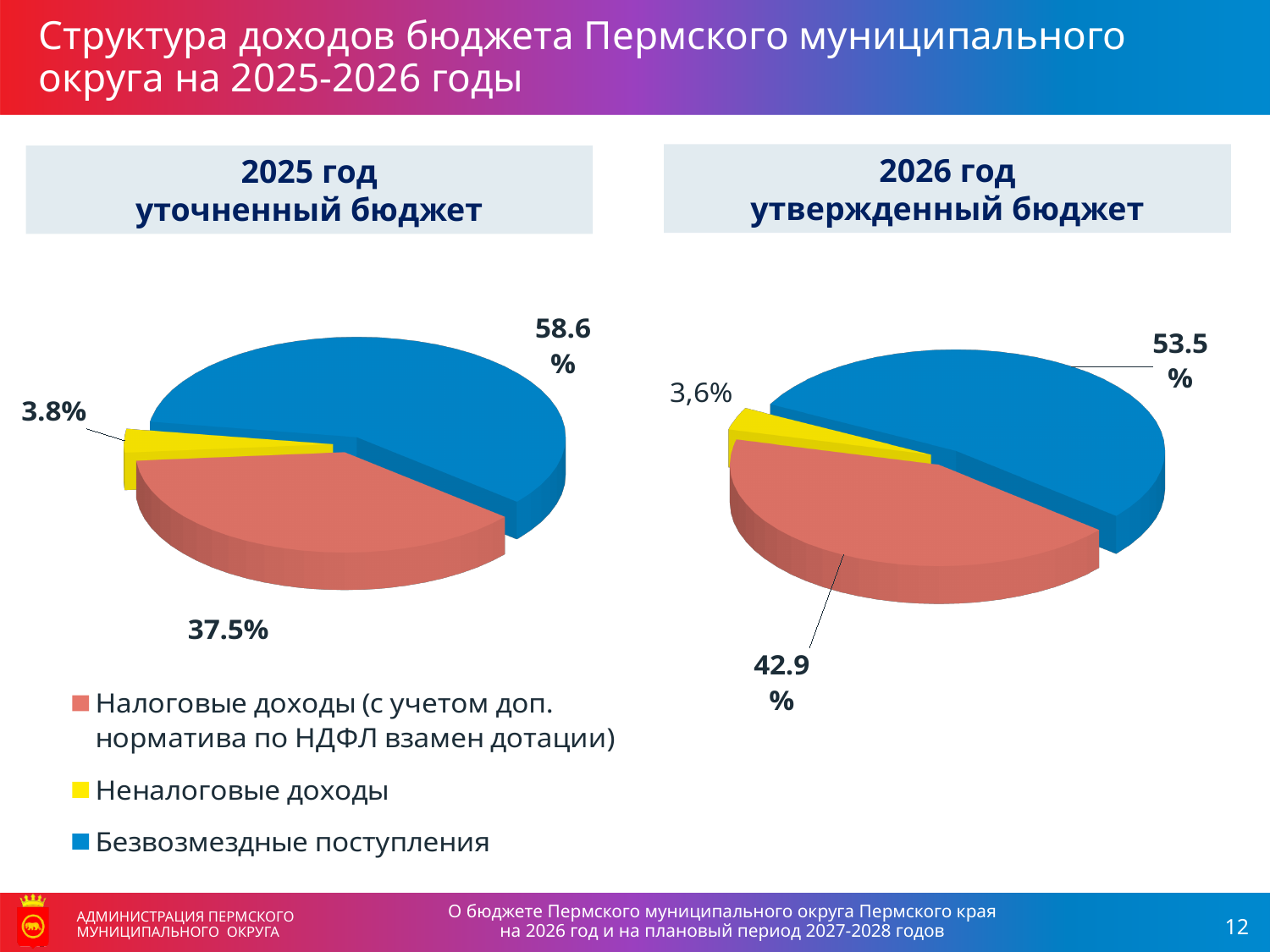
In the 2026 год утвержденный бюджет chart, what share is shown for Безвозмездные поступления? 53.5% In the 2026 год утвержденный бюджет chart, which category has the smallest share? Неналоговые доходы How many categories does the legend list? 3 In the 2025 год уточненный бюджет chart, what share is shown for Безвозмездные поступления? 58.6% In the 2025 год уточненный бюджет chart, which category has the largest share? Безвозмездные поступления In the 2026 год утвержденный бюджет chart, what is the difference between the shares of Безвозмездные поступления and Налоговые доходы? 10.6% In the 2025 год уточненный бюджет chart, what share is shown for Налоговые доходы? 37.5% In the 2025 год уточненный бюджет chart, what share is shown for Неналоговые доходы? 3.8% In the 2026 год утвержденный бюджет chart, what share is shown for Неналоговые доходы? 3,6% In the 2026 год утвержденный бюджет chart, what share is shown for Налоговые доходы? 42.9% Which is larger: the share of Налоговые доходы in the 2025 chart or in the 2026 chart? 2026 What type of chart is used on this slide? Pie chart